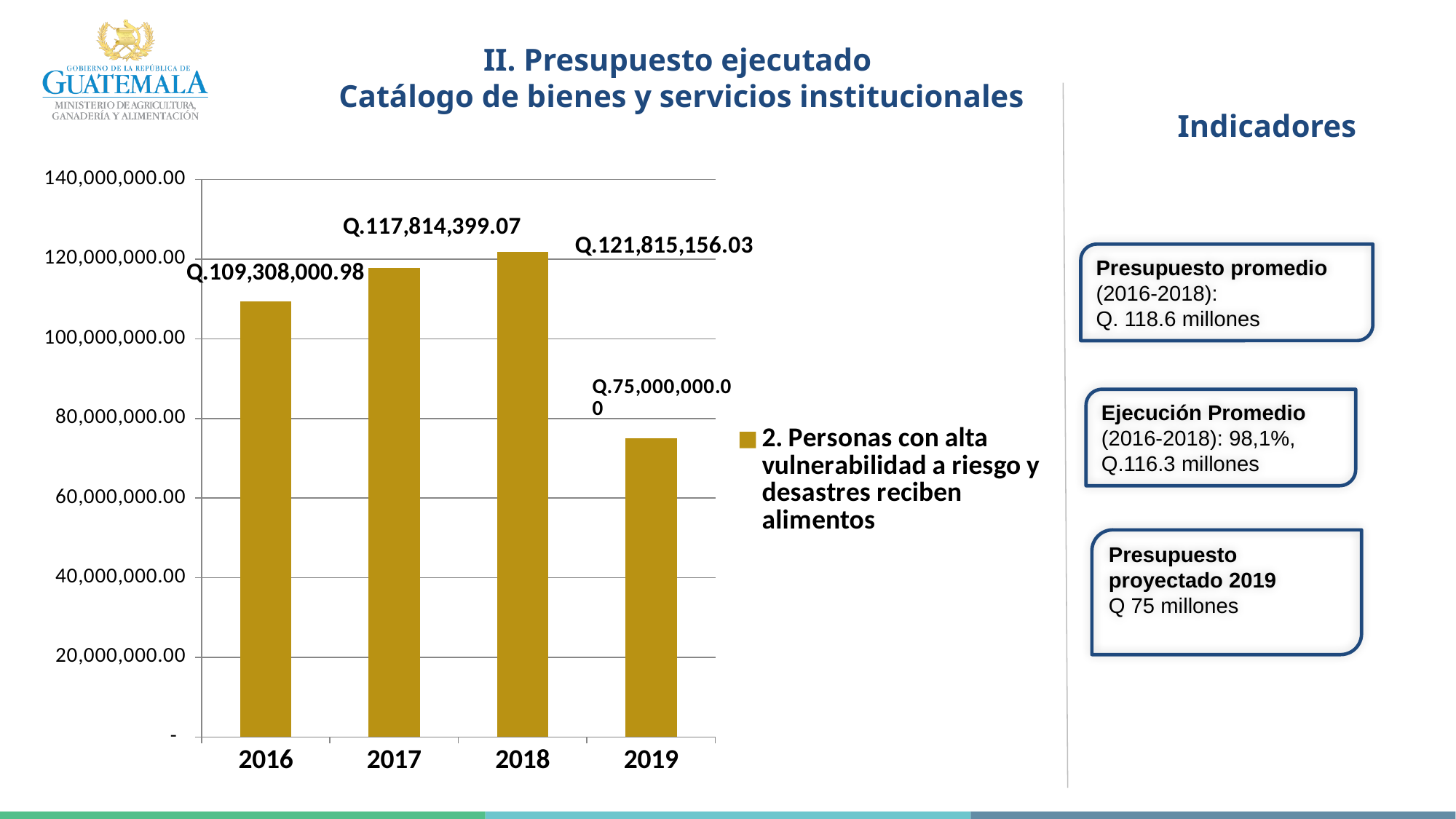
Which year has the lowest value? 2019 What is the value for 2017? Q.117,814,399.07 What is the difference between the values for 2018 and 2017? Q.4,000,756.96 What is the value for 2016? Q.109,308,000.98 Which is larger, the value for 2016 or the value for 2017? 2017 How many series does the chart legend list? 1 How many years are shown on the x axis of the chart? 4 Which year has the highest value? 2018 What is the value for 2019? Q.75,000,000.00 What type of chart is shown on the slide? Bar chart What is the value for 2018? Q.121,815,156.03 What is the difference between the values for 2018 and 2019? Q.46,815,156.03